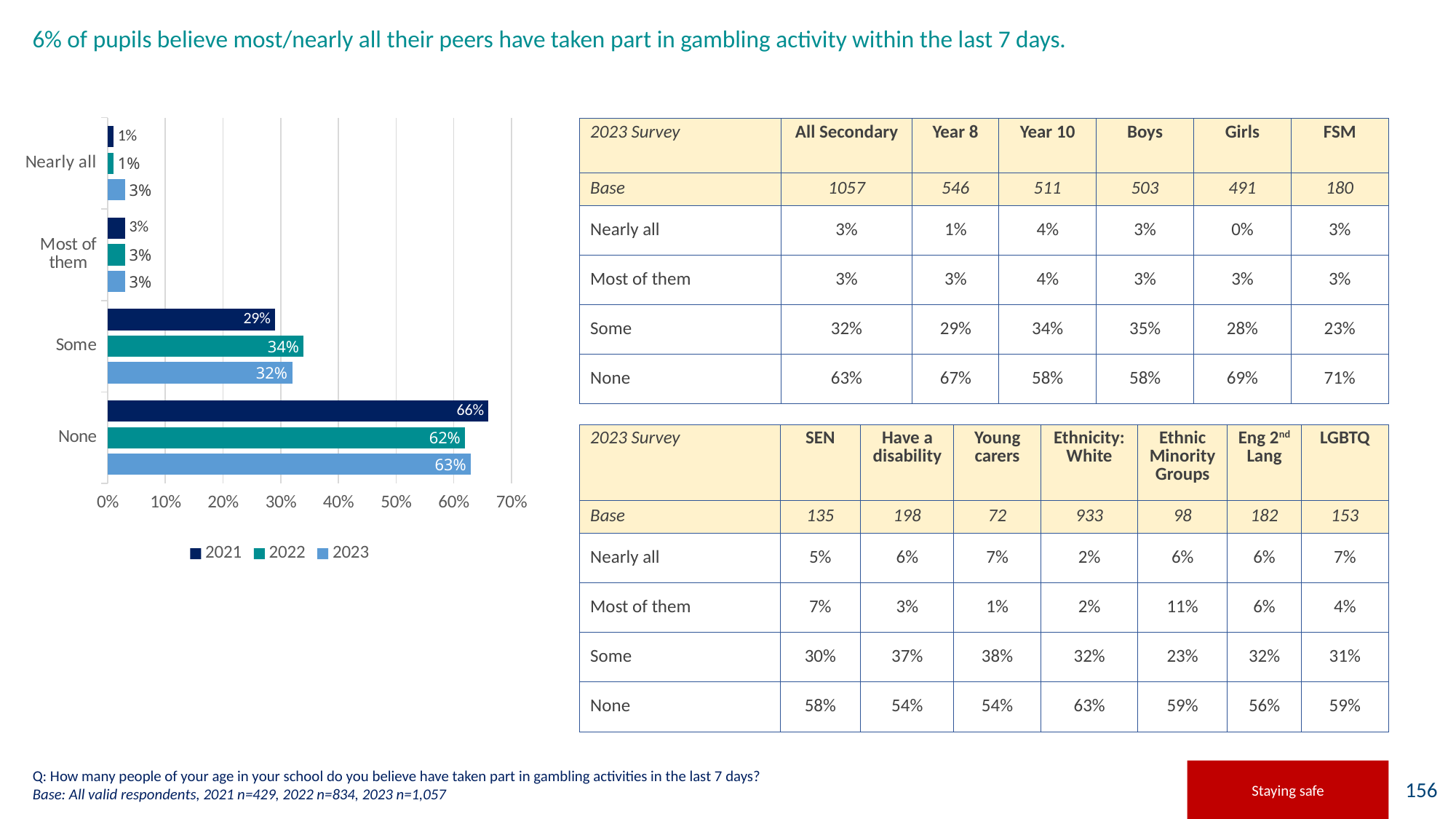
What is the 2023 value for 'None' in the chart? 63% Which category has the lowest value for the 2023 series? Most of them and Nearly all (both 3%) Which is larger for 'Some': the 2021 value or the 2023 value? 2023 What is the difference between the 2021 and 2022 values for 'None'? 4% What is the 2021 value for 'Nearly all' in the chart? 1% Which series is shown in the darkest blue colour in the chart? 2021 What kind of chart is shown on the slide? bar chart What is the 2022 value for 'Some' in the chart? 34% Which category has the highest value for the 2021 series? None How many categories are shown on the chart's vertical axis? 4 How many series does the chart legend list? 3 Is the 2021 value for 'None' greater or less than 60%? greater